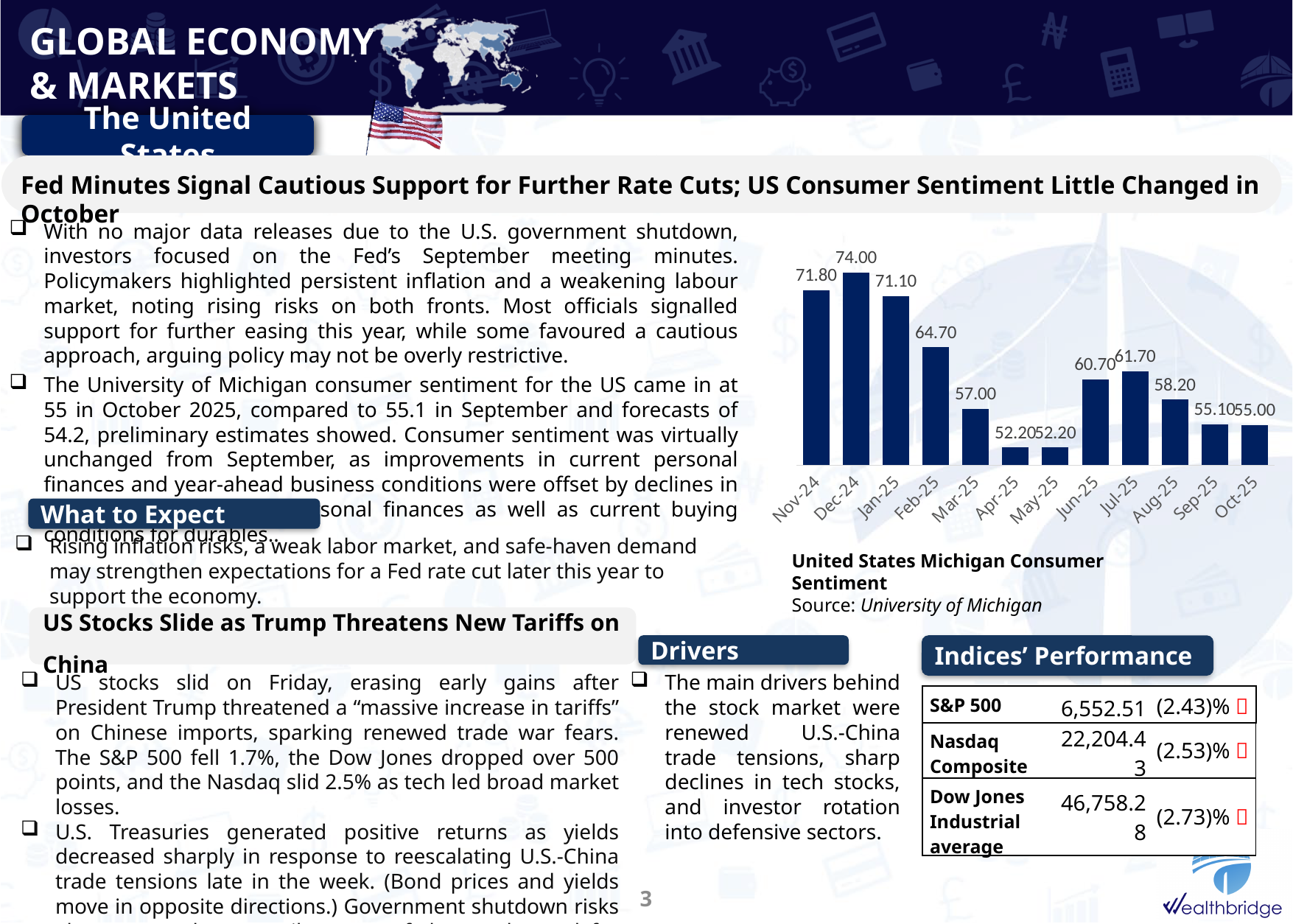
What is the lowest Michigan Consumer Sentiment value shown in the chart? 52.20 How many months are shown in the Michigan Consumer Sentiment chart? 12 Which is larger, the Michigan Consumer Sentiment value for Jun-25 or Jul-25? Jul-25 What is the Michigan Consumer Sentiment value for Dec-24? 74.00 Does the Michigan Consumer Sentiment generally rise or fall from Nov-24 to May-25? Fall What is the Michigan Consumer Sentiment value for Feb-25? 64.70 What type of chart is used to show the United States Michigan Consumer Sentiment? Bar chart Which month has the highest Michigan Consumer Sentiment value in the chart? Dec-24 What is the difference between the Michigan Consumer Sentiment values for Dec-24 and Oct-25? 19.00 What is the Michigan Consumer Sentiment value for Oct-25? 55.00 What is the difference between the Michigan Consumer Sentiment values for Jan-25 and Feb-25? 6.40 What is the source cited for the Michigan Consumer Sentiment chart? University of Michigan